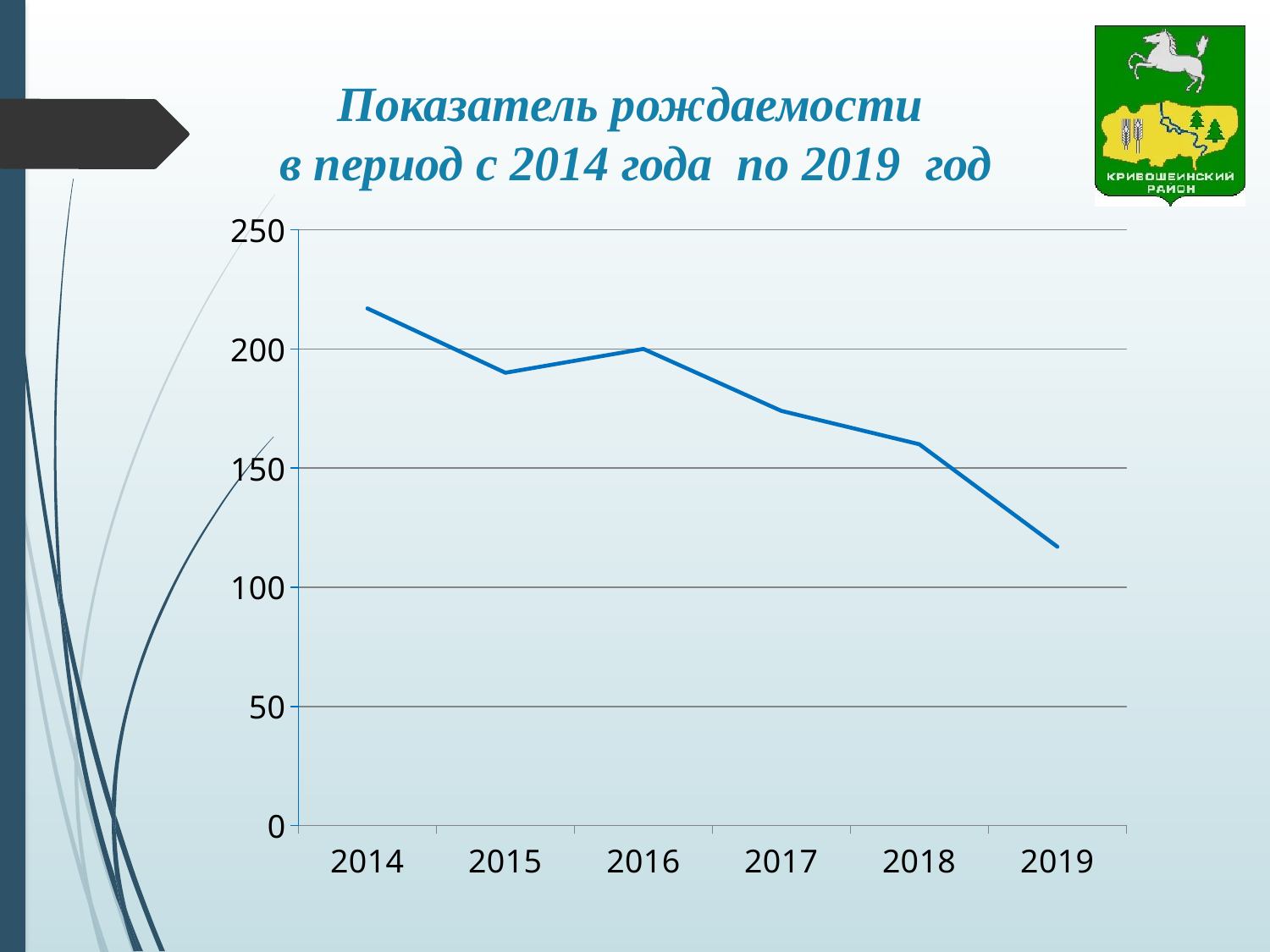
Which is larger, the value for 2016 or the value for 2015? 2016 Is the value for 2018 greater or less than 150? greater Which year has the lowest value? 2019 Overall, do the values rise or fall from 2014 to 2019? fall Which year has the highest value? 2014 Is the value for 2015 greater or less than 200? less How many years are plotted on the x axis? 6 Is the value for 2014 greater or less than 200? greater What kind of chart is shown on the slide? line chart Which is larger, the value for 2017 or the value for 2019? 2017 What is the title of the chart? Показатель рождаемости в период с 2014 года по 2019 год